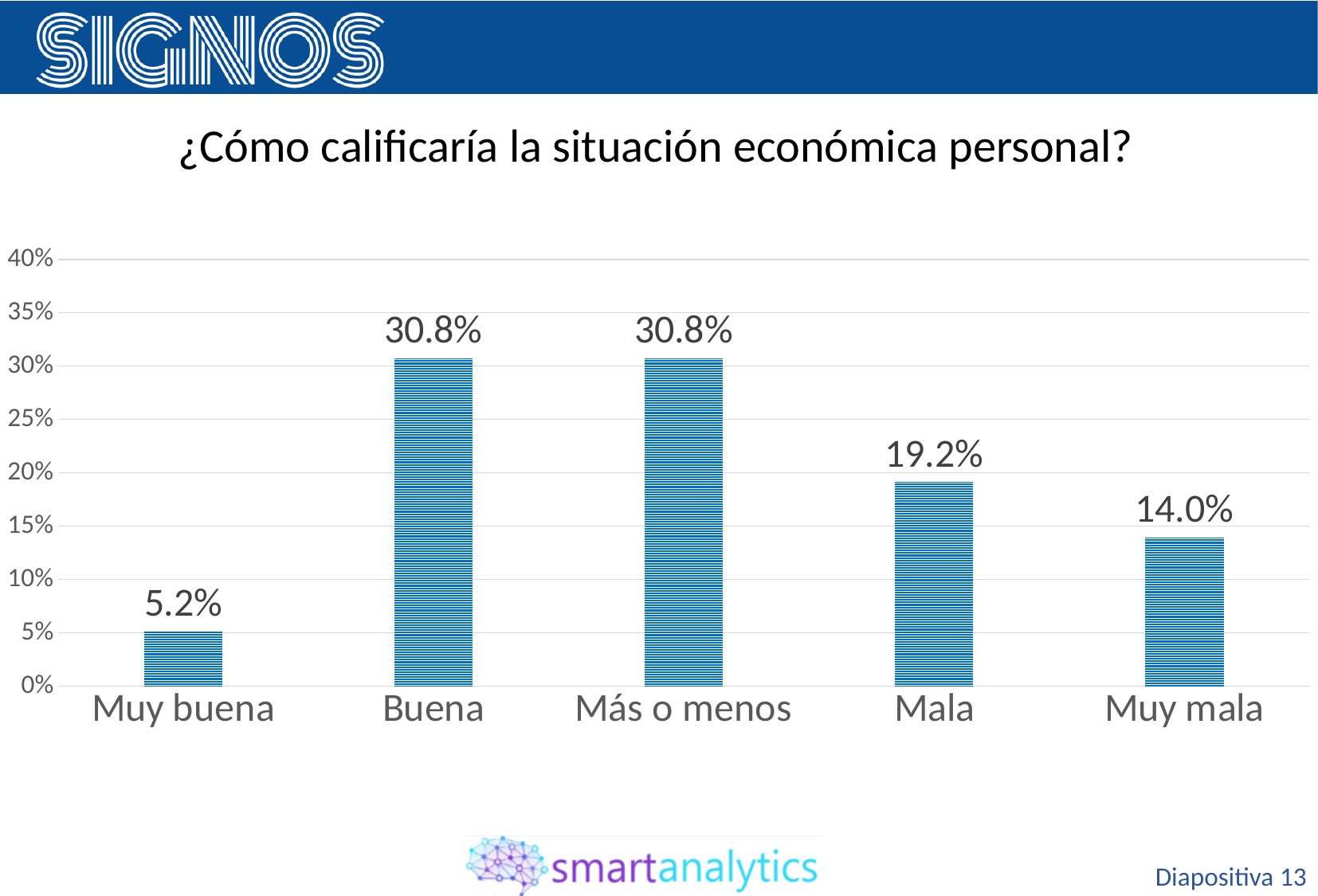
What kind of chart is shown on the slide? Bar chart What is the value for "Muy mala"? 14.0% What is the value for "Mala"? 19.2% What is the value for "Muy buena"? 5.2% Which is larger, the value for "Mala" or the value for "Muy mala"? Mala Is the value for "Más o menos" greater or less than 25%? greater What is the difference between the values for "Buena" and "Muy buena"? 25.6% What is the value for "Buena"? 30.8% What is the title of the chart? ¿Cómo calificaría la situación económica personal? How many categories are shown on the x axis? 5 Which category has the lowest value? Muy buena What is the difference between the values for "Mala" and "Muy mala"? 5.2%